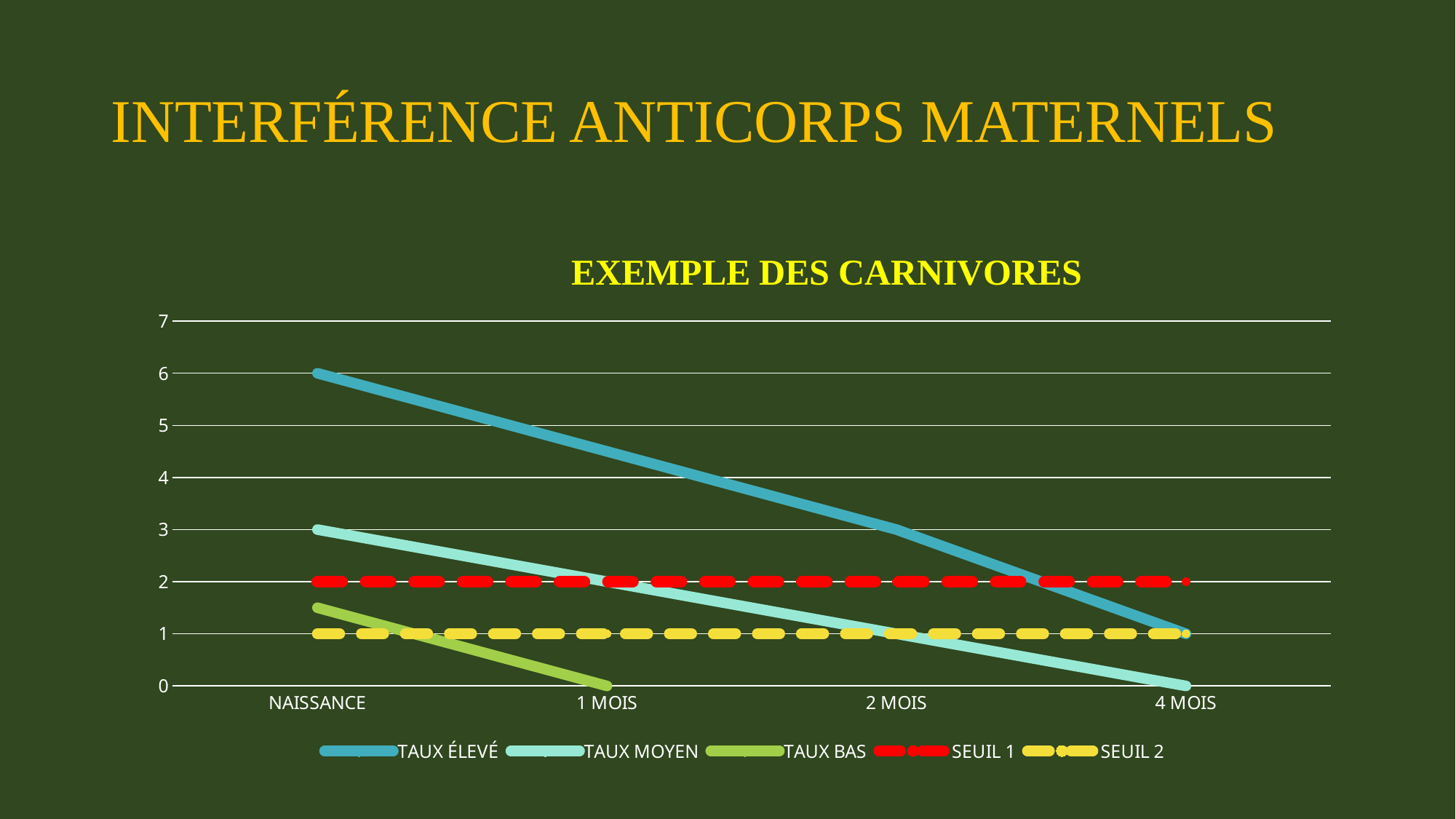
At NAISSANCE, which is larger: TAUX ÉLEVÉ or TAUX MOYEN? TAUX ÉLEVÉ How many categories are shown on the x axis? 4 At what constant value is the SEUIL 1 line drawn? 2 What is the value of TAUX ÉLEVÉ at 4 MOIS? 1 By how much does TAUX ÉLEVÉ decrease between NAISSANCE and 4 MOIS? 5 What is the value of TAUX ÉLEVÉ at NAISSANCE? 6 What kind of chart is shown on the slide? line chart How many series does the legend list? 5 What is the title of the chart? EXEMPLE DES CARNIVORES What is the value of TAUX MOYEN at NAISSANCE? 3 Does the TAUX ÉLEVÉ line rise or fall from NAISSANCE to 4 MOIS? fall Is the value of TAUX ÉLEVÉ at 1 MOIS greater or less than 4? greater